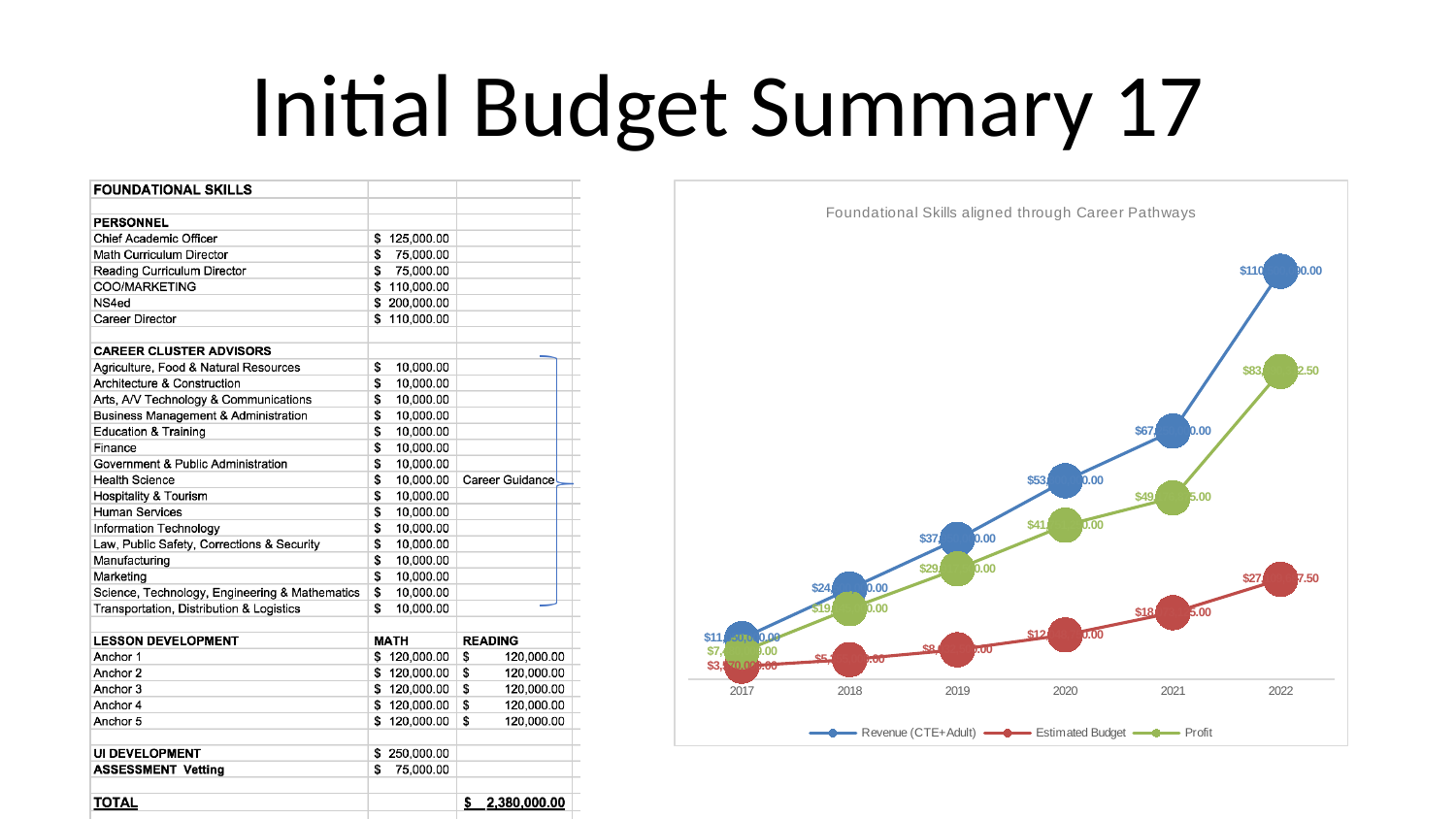
What kind of chart is shown on the slide? line chart How many years are shown along the x axis of the chart? 6 What is the title of the chart? Foundational Skills aligned through Career Pathways In 2021, which is larger: Revenue (CTE+Adult) or Profit? Revenue (CTE+Adult) How many series does the chart legend list? 3 Which series has the lowest value in 2022? Estimated Budget Which series is drawn in red in the chart? Estimated Budget In which year does the Revenue (CTE+Adult) series reach its highest value? 2022 Does the Revenue (CTE+Adult) series rise or fall from 2017 to 2022? rise In 2020, which is larger: Profit or Estimated Budget? Profit Does the Profit series rise or fall from 2017 to 2022? rise Which series has the highest value in 2022? Revenue (CTE+Adult)